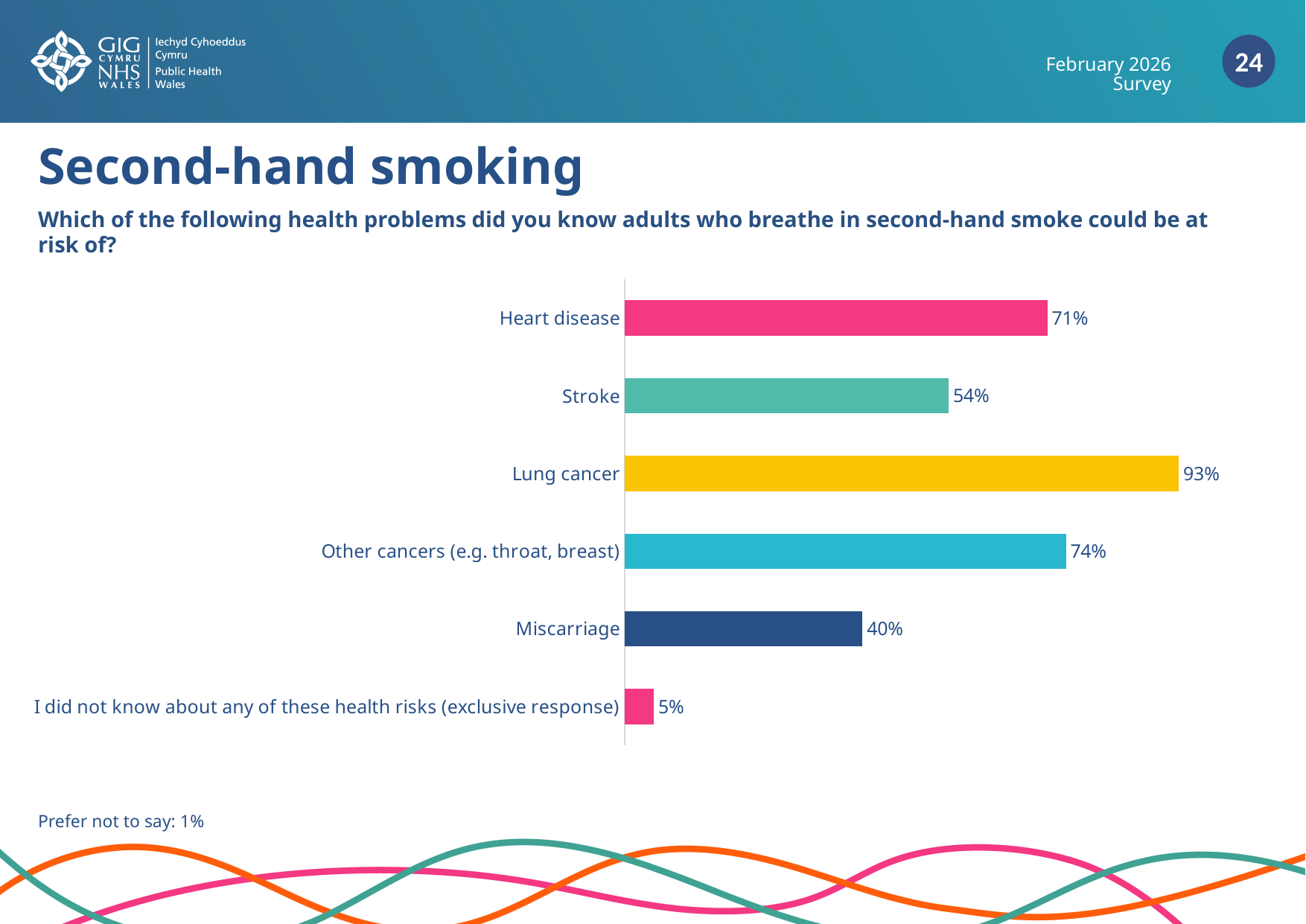
What percentage of respondents knew that heart disease is a risk for adults who breathe in second-hand smoke? 71% What type of chart is shown on the slide? Bar chart What is the difference in percentage points between Other cancers (e.g. throat, breast) and Heart disease? 3 Which has a higher value, Heart disease or Stroke? Heart disease What percentage is given for 'Prefer not to say' below the chart? 1% What is the difference in percentage points between Lung cancer and Stroke? 39 What percentage is shown for Miscarriage? 40% Which health problem has the highest percentage on the chart? Lung cancer What is the value for 'I did not know about any of these health risks (exclusive response)'? 5% Which response has the lowest percentage on the chart? I did not know about any of these health risks (exclusive response) How many bars are shown on the chart? 6 What is the value shown for Stroke? 54%